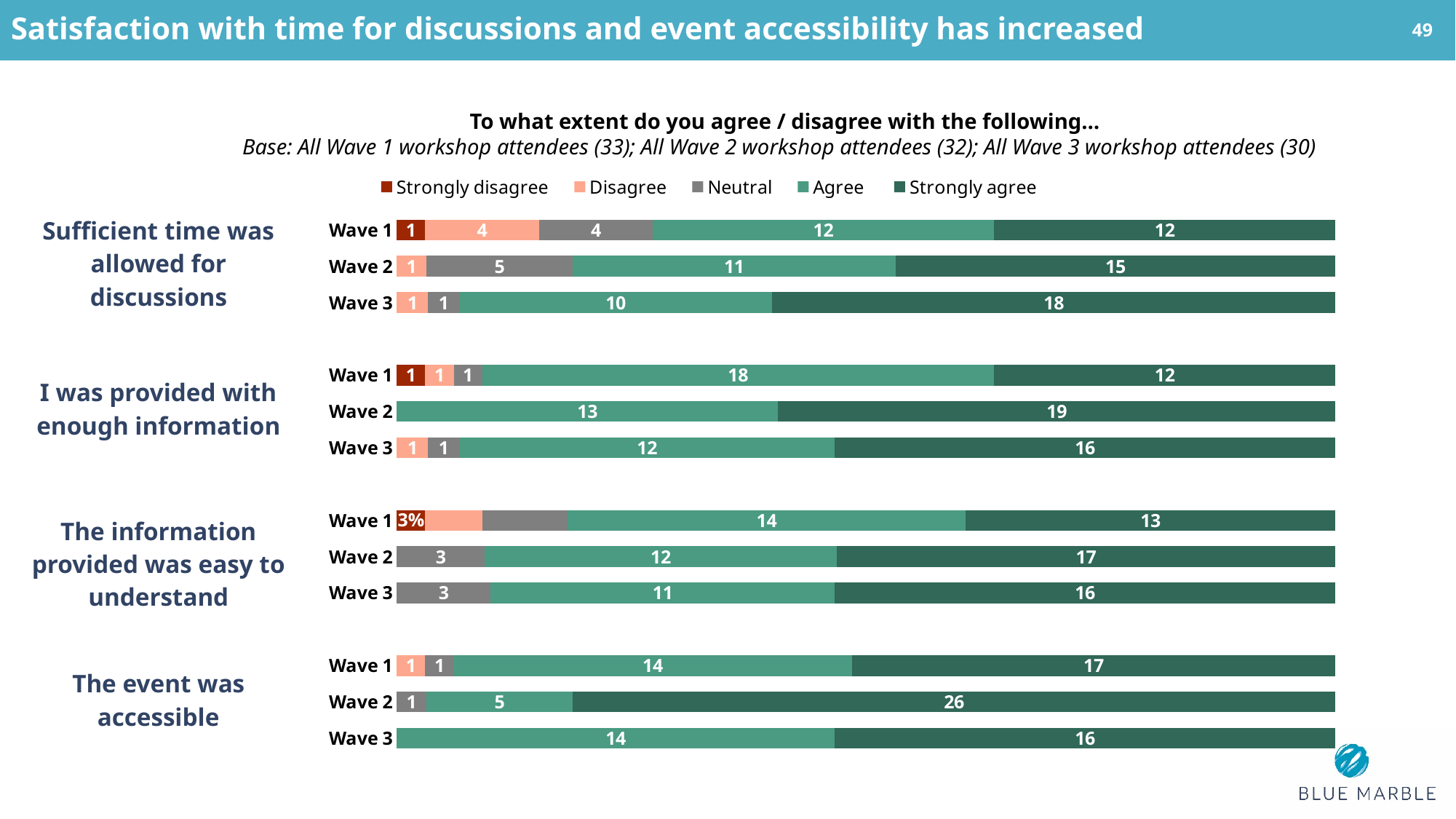
In the 'I was provided with enough information' chart, what is the Agree value for Wave 1? 18 In the 'I was provided with enough information' chart, is the Strongly agree value larger for Wave 2 or Wave 3? Wave 2 In the 'Sufficient time was allowed for discussions' chart, what is the Strongly agree value for Wave 3? 18 What kind of chart is used on this slide? Stacked bar chart In the 'The event was accessible' chart, which wave has the highest Strongly agree value? Wave 2 How many series does the legend list? 5 In the 'I was provided with enough information' chart, what is the total of the Wave 2 bar? 32 In the 'Sufficient time was allowed for discussions' chart, what is the Neutral value for Wave 2? 5 In the 'The event was accessible' chart, what is the Strongly agree value for Wave 2? 26 Which legend entry is shown in dark red? Strongly disagree In the 'The information provided was easy to understand' chart, what is the difference between the Strongly agree values for Wave 2 and Wave 3? 1 In the 'Sufficient time was allowed for discussions' chart, which wave has the lowest Strongly agree value? Wave 1